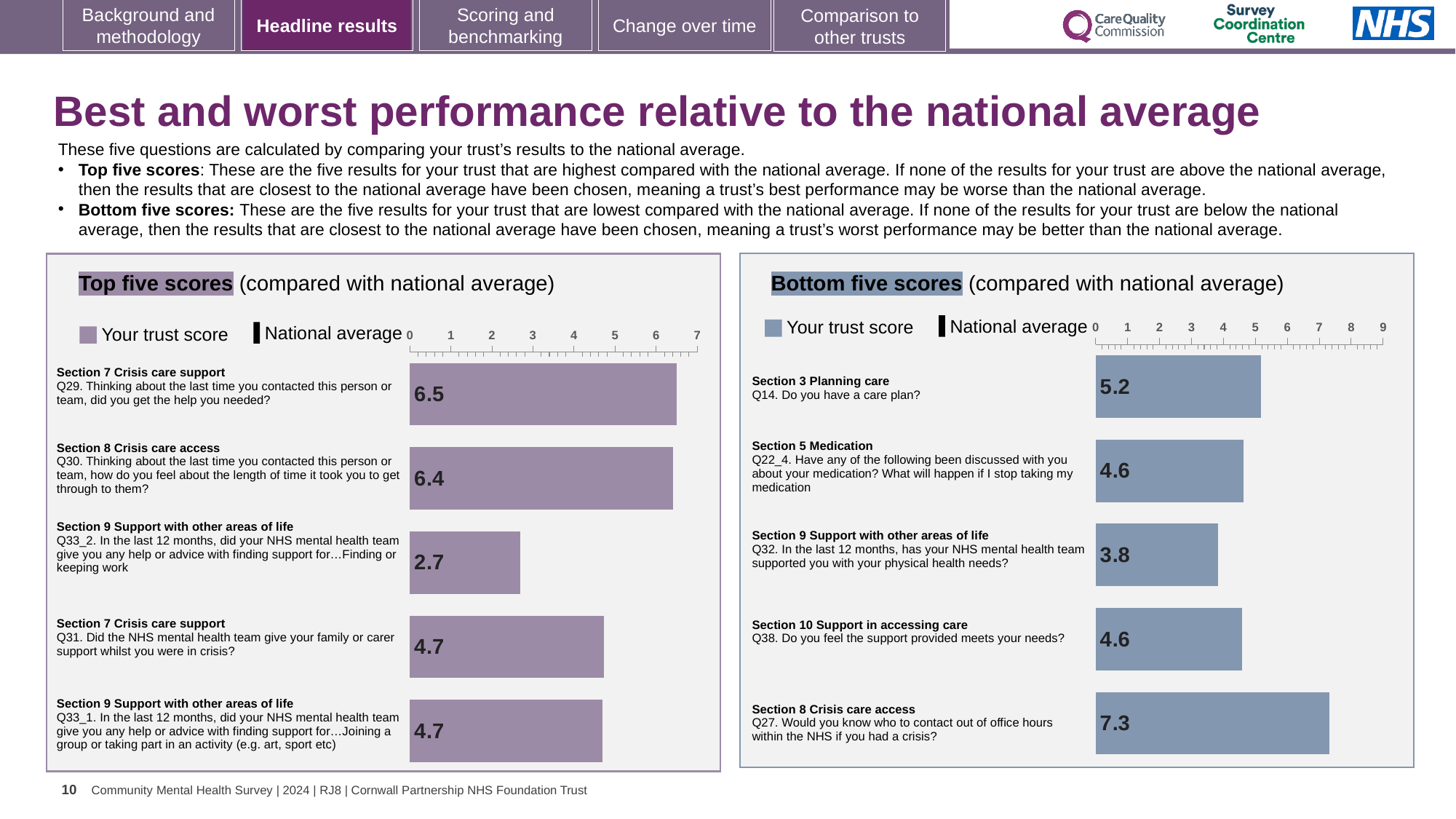
In the Top five scores chart, what is the trust score for Q29 (did you get the help you needed)? 6.5 In the Bottom five scores chart, what is the trust score for Q32 (supported you with your physical health needs)? 3.8 What type of chart is used for the Bottom five scores? Bar chart In the Top five scores chart, what is the difference between the trust scores for Q29 and Q33_2? 3.8 In the Bottom five scores chart, what is the trust score for Q27 (would you know who to contact out of office hours)? 7.3 How many bars are plotted in the Top five scores chart? 5 In the Bottom five scores chart, what is the difference between the trust scores for Q27 and Q32? 3.5 In the Bottom five scores chart, which has the larger trust score, Q14 or Q22_4? Q14 In the Top five scores chart, which question has the highest trust score? Q29 (6.5) In the Bottom five scores chart, which question has the lowest trust score? Q32 (3.8) In the Top five scores chart, which question has the lowest trust score? Q33_2 (2.7) In the Bottom five scores chart, which question has the highest trust score? Q27 (7.3)